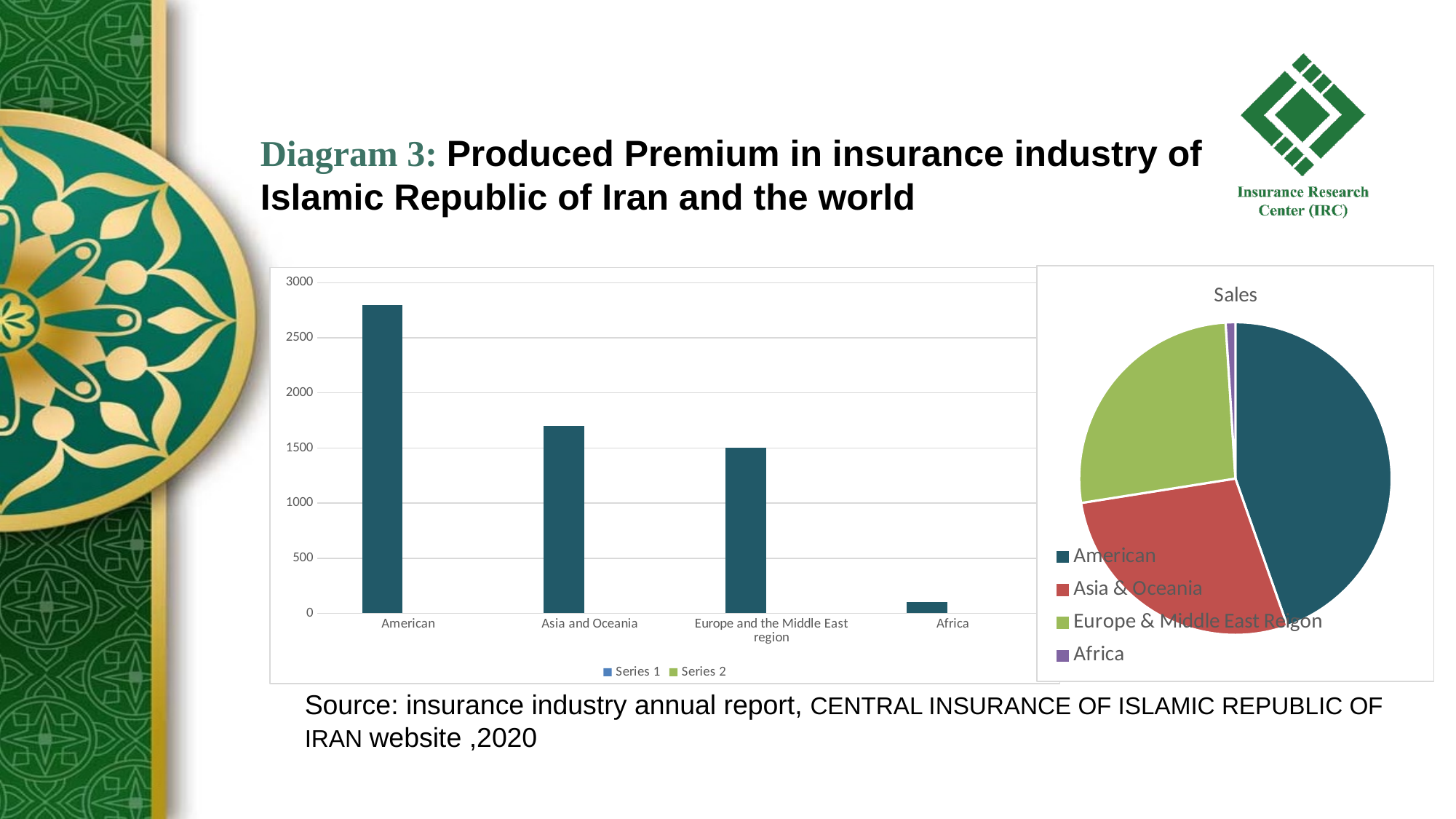
In the bar chart on the left, is the value for Africa greater or less than 500? less How many series does the legend of the bar chart on the left list? 2 In the bar chart on the left, is the value for Asia and Oceania greater or less than 2000? less What kind of chart is the chart on the left of the slide? bar chart In the bar chart on the left, is the value for American greater or less than 2500? greater How many categories are shown on the x axis of the bar chart on the left? 4 In the bar chart on the left, which is larger: the value for Asia and Oceania or the value for Europe and the Middle East region? Asia and Oceania In the pie chart titled Sales, which slice is the largest? American In the bar chart on the left, which category has the lowest value? Africa In the bar chart on the left, which category has the highest value? American In the bar chart on the left, do the values rise or fall from left to right along the x axis? fall In the pie chart titled Sales, which slice is the smallest? Africa